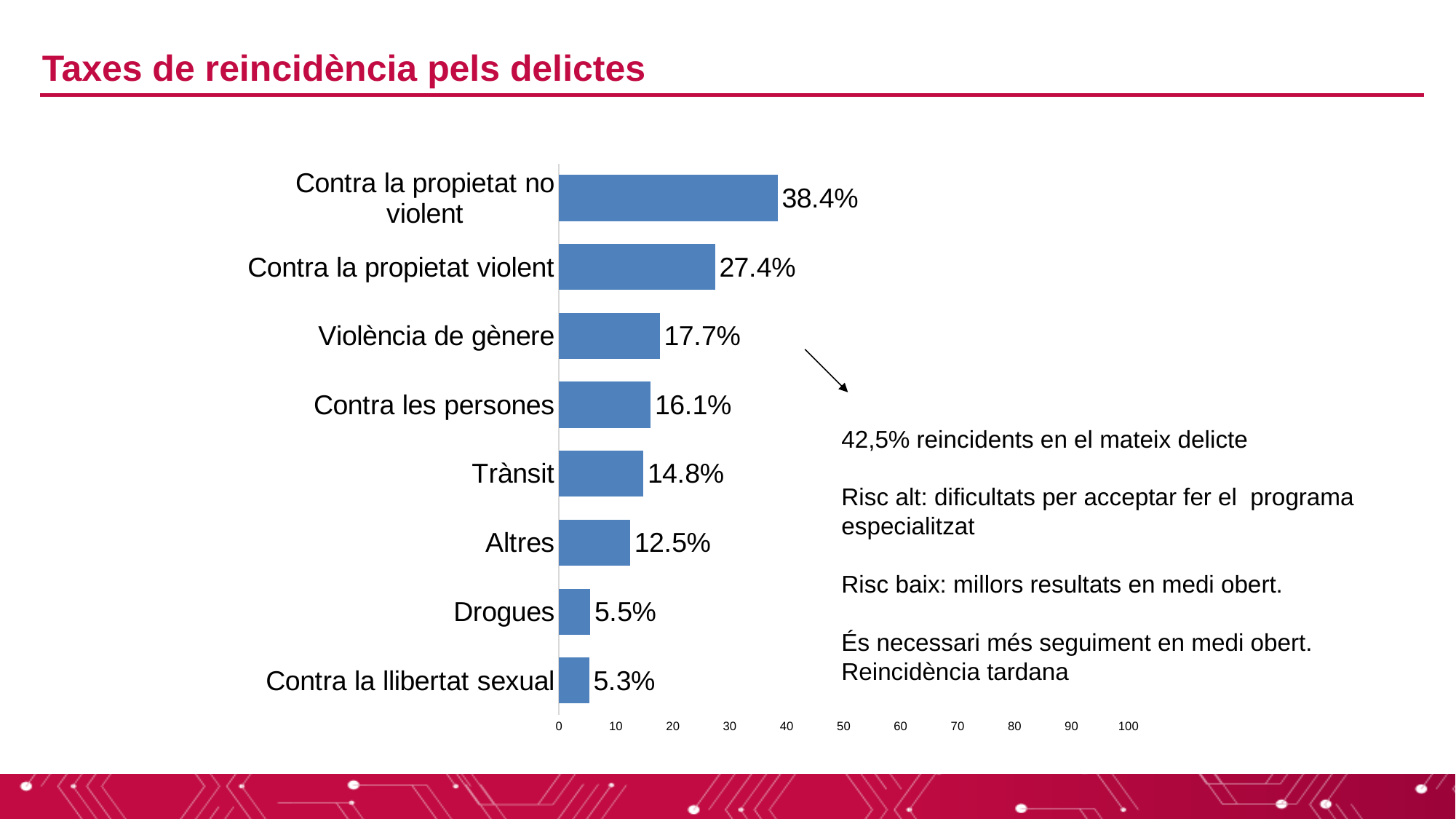
Which is larger, the value for 'Violència de gènere' or for 'Contra les persones'? Violència de gènere What is the title of the slide containing the chart? Taxes de reincidència pels delictes What is the value shown for 'Drogues'? 5.5% Which category has the lowest recidivism rate? Contra la llibertat sexual What kind of chart is shown on the slide? Bar chart What is the value shown for 'Trànsit'? 14.8% What is the difference between the values for 'Contra la propietat no violent' and 'Contra la propietat violent'? 11.0 percentage points Which category has the highest recidivism rate? Contra la propietat no violent What is the highest tick value shown on the horizontal axis? 100 How many categories are shown in the chart? 8 What is the recidivism rate for 'Contra la propietat no violent'? 38.4% Is the value for 'Altres' greater or less than 20? less